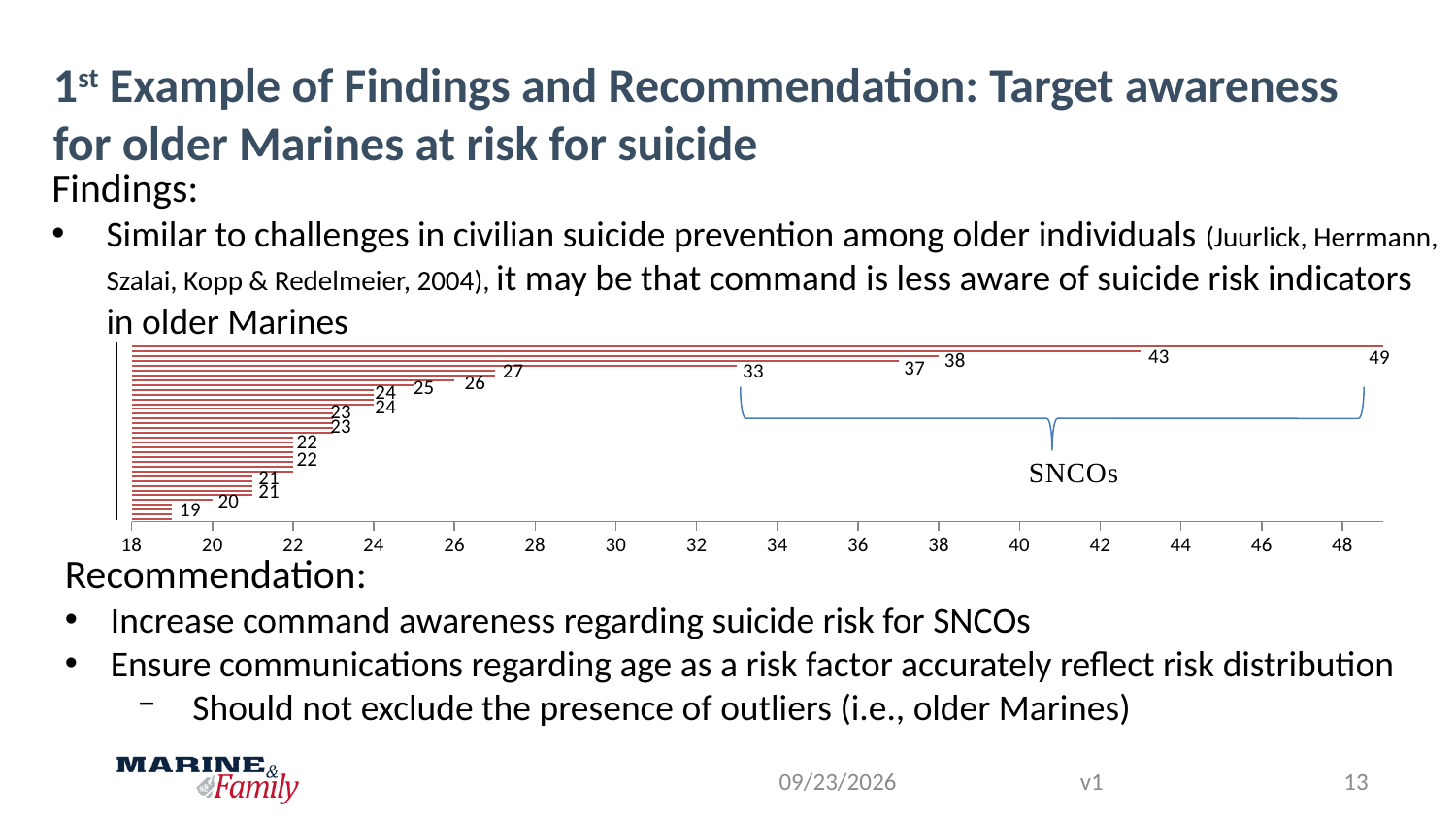
Is the shortest bar's value greater or less than 20? less What is the smallest value labeled on the chart? 19 What kind of chart is shown on the slide? bar chart What is the difference between the largest labeled value (49) and the smallest labeled value (19)? 30 What is the highest tick value shown on the x axis? 48 How many bars have a labeled value of 40 or more? 2 What is the largest value labeled on the chart? 49 What is the lowest value shown on the x axis? 18 What is the difference between the two largest labeled values, 49 and 43? 6 What label is written beneath the brace spanning the longest bars (33 to 49)? SNCOs Which is larger, the bar labeled 33 or the bar labeled 27? 33 Is the longest bar's value greater or less than 48? greater